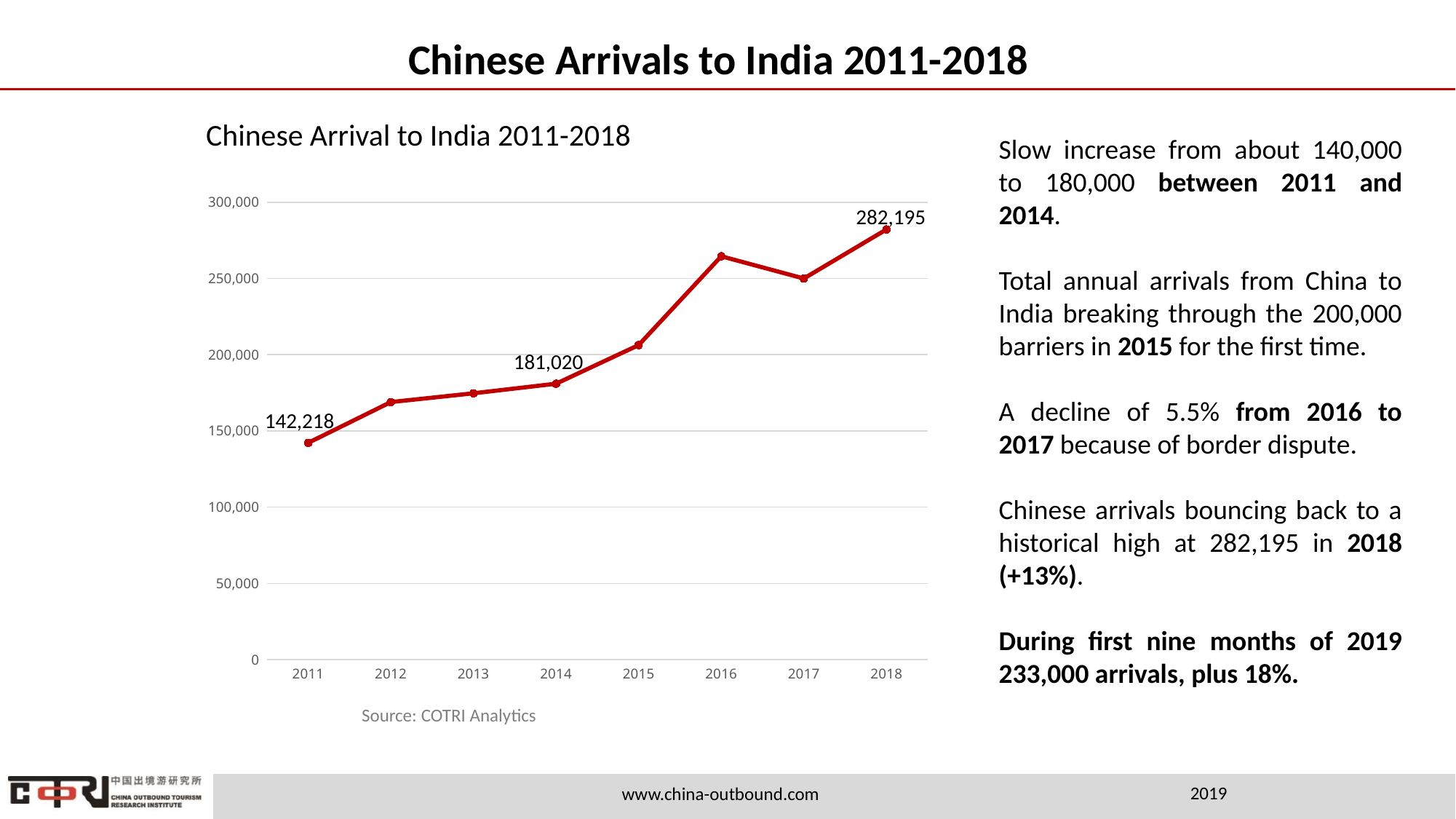
Which is larger, the value for 2016 or the value for 2017? 2016 What is the value for 2018? 282,195 Which year has the highest value? 2018 Is the value for 2015 greater or less than 200,000? greater Which year has the lowest value? 2011 Is the value for 2016 greater or less than 250,000? greater What kind of chart is shown? line chart What is the difference between the values for 2018 and 2011? 139,977 What is the value for 2014? 181,020 How many years are plotted on the chart? 8 What is the value for 2011? 142,218 What is the difference between the values for 2014 and 2011? 38,802